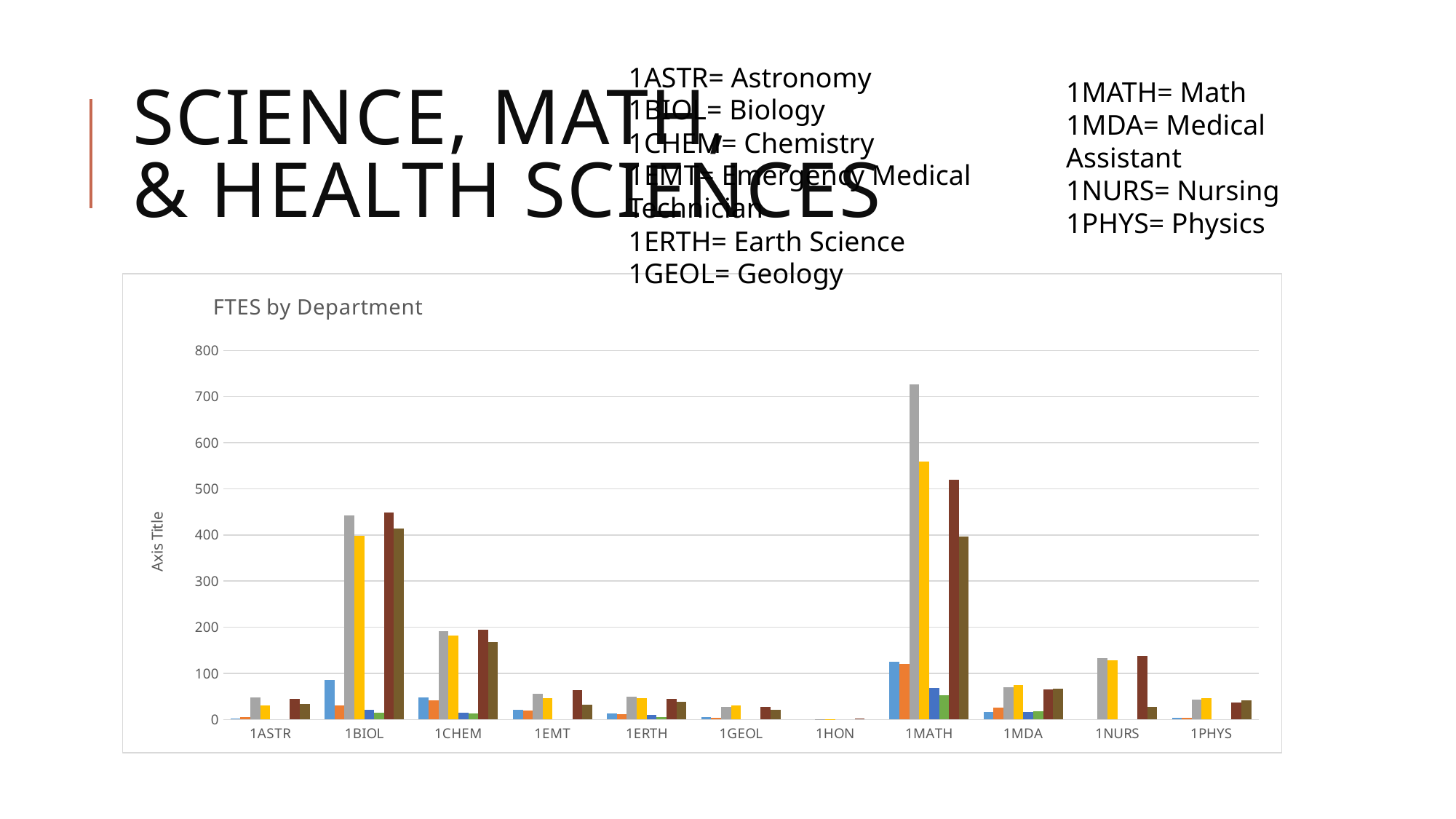
What is the title of the chart? FTES by Department How many departments (categories) are shown on the x axis of the chart? 11 Are all the bars for 1HON greater or less than 100? less What is the label shown on the vertical axis of the chart? Axis Title Is the tallest bar for 1BIOL greater or less than 400? greater Which department has the tallest bar in the chart? 1MATH Is the tallest bar for 1NURS greater or less than 100? greater Which department has the smallest bars overall in the chart? 1HON Which department has a taller maximum bar, 1BIOL or 1MATH? 1MATH What type of chart is shown on the slide? bar chart